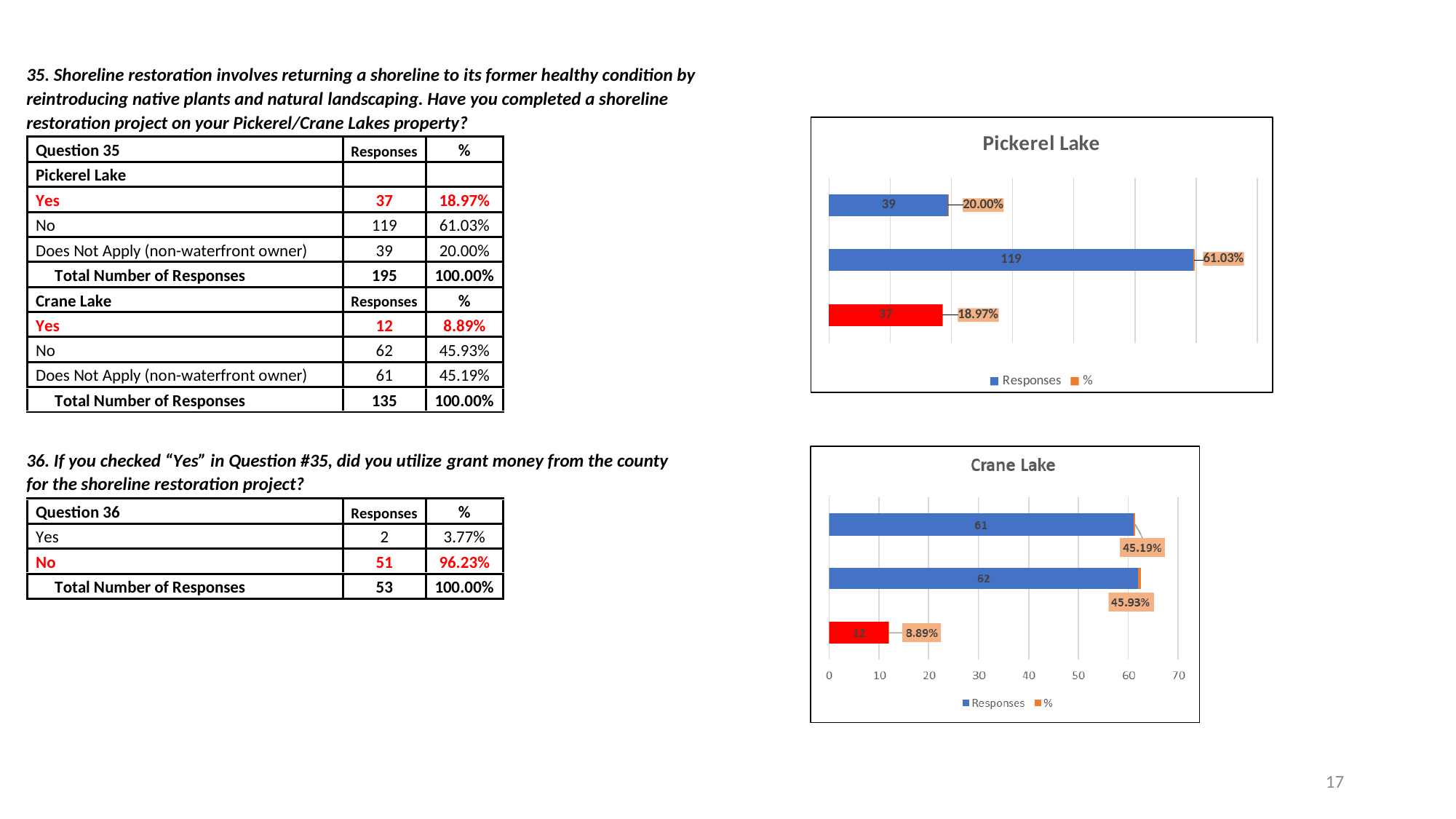
How many bars are plotted for the Responses series in the Pickerel Lake chart? 3 In the Pickerel Lake chart, what is the Responses value shown on the red bar? 37 In the Pickerel Lake chart, what is the difference between the Responses values of the middle bar (119) and the top bar (39)? 80 In the Crane Lake chart, is the Responses value of the middle bar greater or less than 50? greater In the Crane Lake chart, what is the difference between the Responses values of the middle bar (62) and the red bar (12)? 50 In the Crane Lake chart, what is the lowest Responses value shown? 12 What kind of chart is the Pickerel Lake chart? bar chart In the Pickerel Lake chart, what percentage label appears next to the longest bar? 61.03% In the Pickerel Lake chart, what is the highest Responses value shown? 119 How many series does the legend of the Pickerel Lake chart list? 2 In the Crane Lake chart, what percentage label is shown for the top bar? 45.19% In the Crane Lake chart, what is the Responses value shown on the red bar? 12